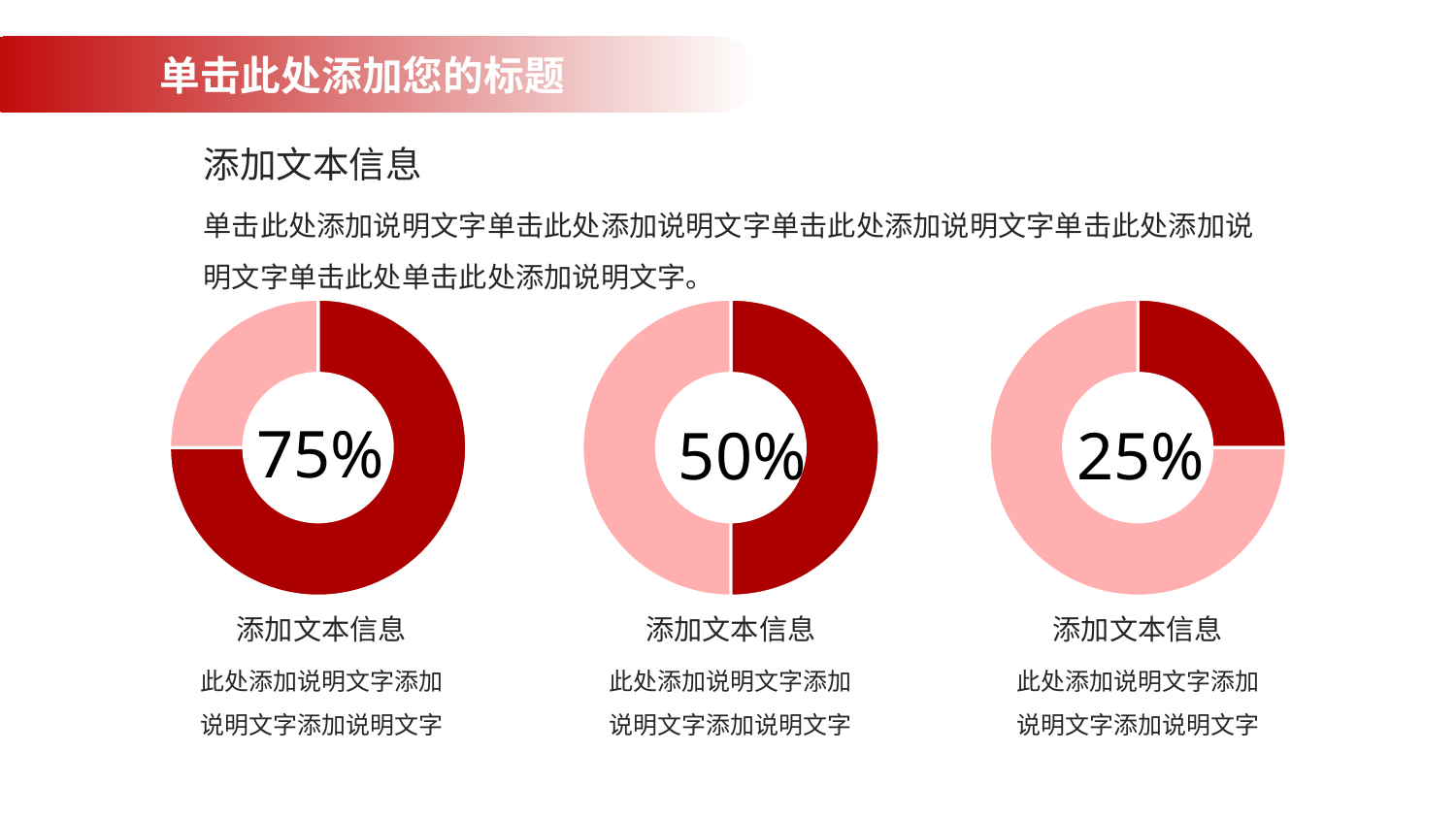
What percentage is shown in the centre of the left donut chart? 75% How many donut charts are on the slide? 3 Do the percentages in the donut charts increase or decrease from left to right across the slide? Decrease In the right donut chart, what share of the ring is filled with the dark red colour? 25% What is the difference between the percentage in the middle donut chart and the percentage in the right donut chart? 25% Is the percentage in the left donut chart larger or smaller than the percentage in the middle donut chart? Larger Which of the three donut charts shows the highest percentage? The left chart (75%) Which of the three donut charts shows the lowest percentage? The right chart (25%) What percentage is shown in the centre of the right donut chart? 25% What is the difference between the percentage in the left donut chart and the percentage in the right donut chart? 50% What percentage is shown in the centre of the middle donut chart? 50% What kind of chart is used on this slide? Donut (pie) chart